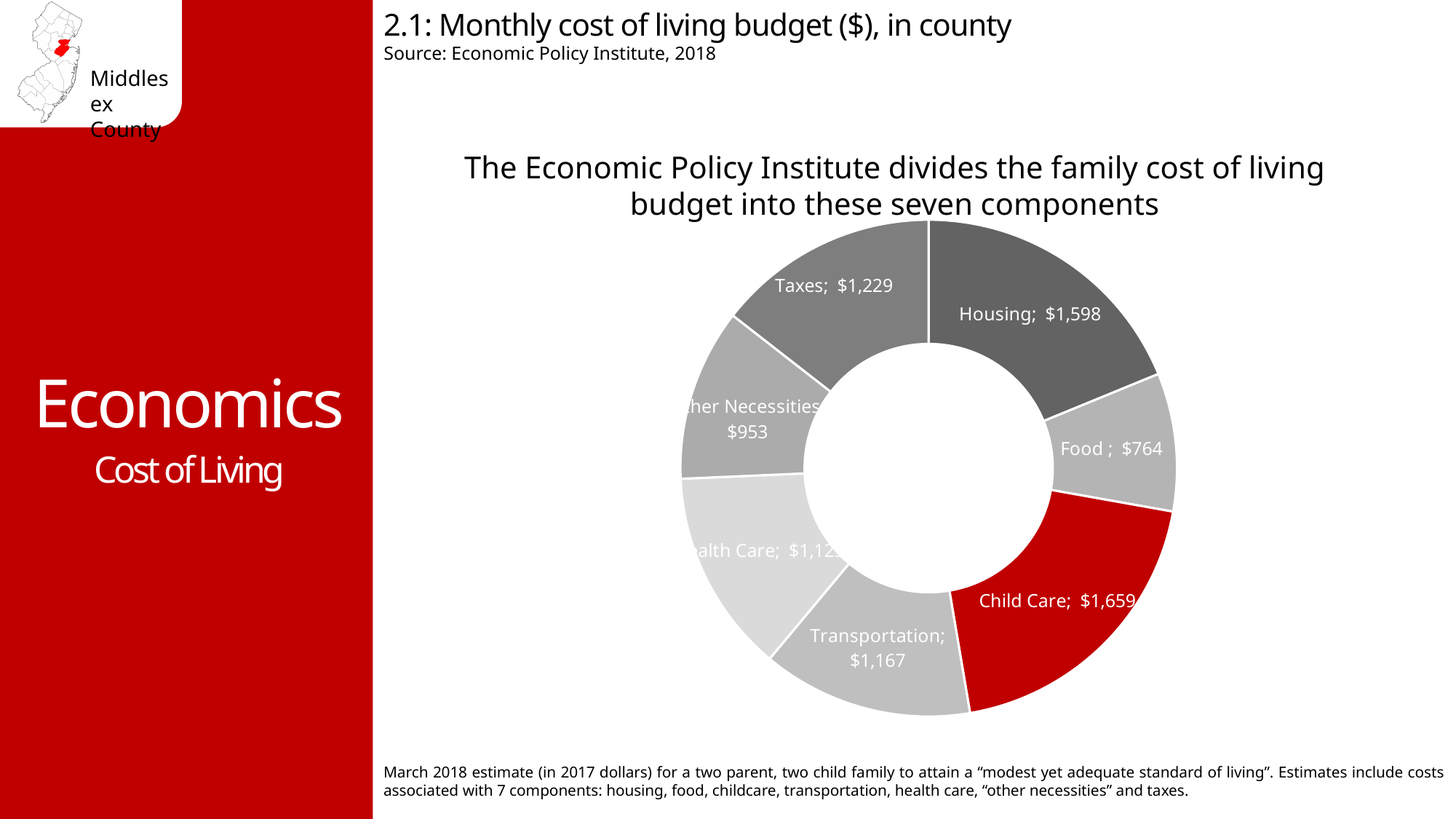
What kind of chart is shown on the slide? Doughnut (pie) chart How many components (slices) does the chart show? 7 What is the monthly cost for Transportation? $1,167 Which component has the largest monthly cost? Child Care Which component has the smallest monthly cost? Food What is the monthly cost for Housing? $1,598 Which is larger, the monthly cost for Taxes or for Transportation? Taxes What is the monthly cost for Child Care? $1,659 What is the monthly cost for Food? $764 What is the monthly cost for Taxes? $1,229 How much more per month is Child Care than Housing? $61 Which component is shown in red on the chart? Child Care